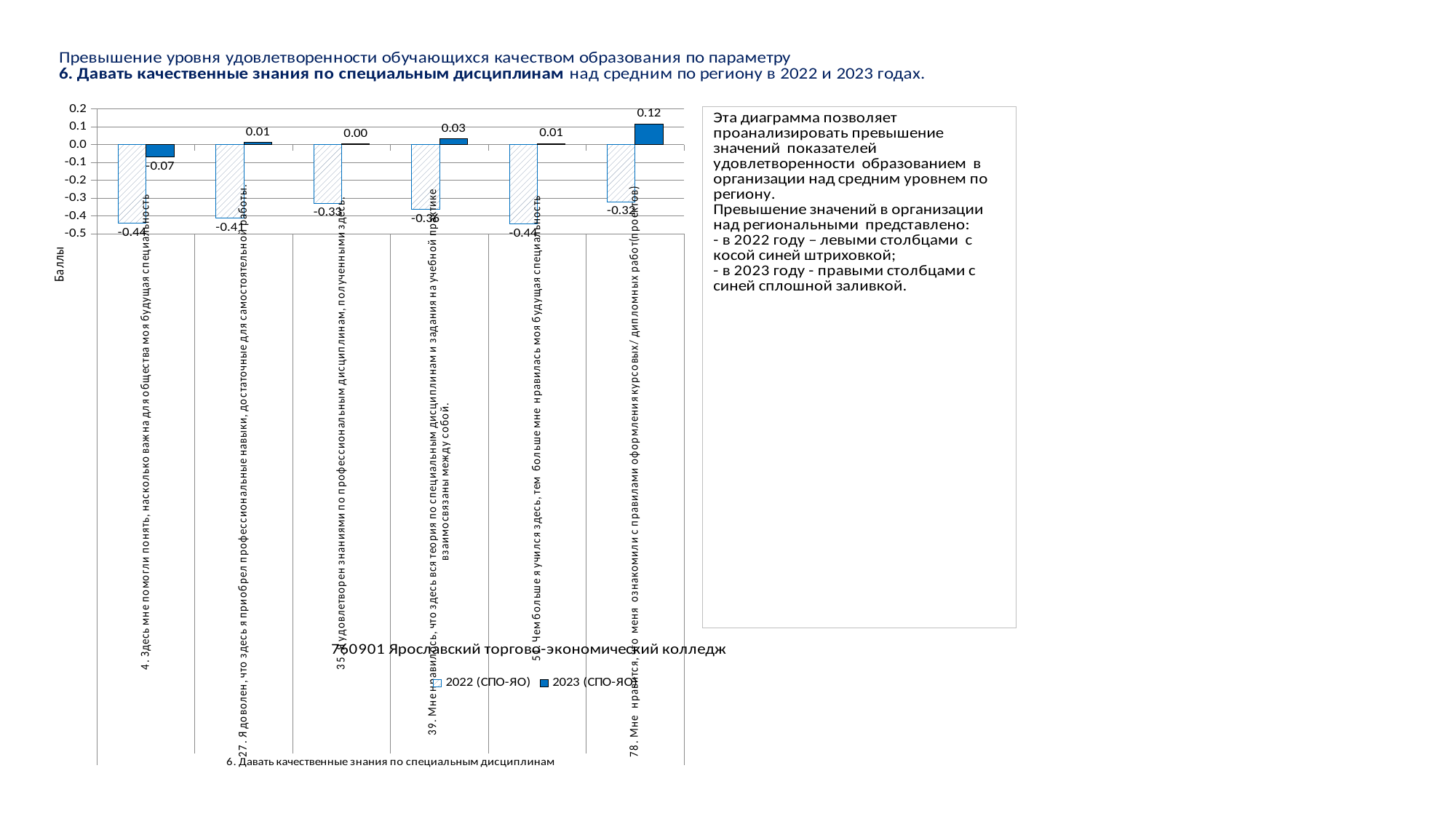
What is the 2023 (СПО-ЯО) value for category 35 (Я удовлетворен знаниями по профессиональным дисциплинам, полученными здесь)? 0.00 What kind of chart is shown on the slide? Bar chart Which category has the highest 2023 (СПО-ЯО) value? 78. Мне нравится, что меня ознакомили с правилами оформления курсовых/дипломных работ Is the 2022 (СПО-ЯО) value for category 27 greater or less than -0.3? less Which is larger, the 2022 (СПО-ЯО) value for category 35 or for category 39? Category 35 What is the difference between the 2023 and 2022 values for category 78? 0.44 What is the 2022 (СПО-ЯО) value for category 4 (Здесь мне помогли понять, насколько важна для общества моя будущая специальность)? -0.44 What are the two series named in the legend? 2022 (СПО-ЯО) and 2023 (СПО-ЯО) What is the 2023 (СПО-ЯО) value for category 78 (Мне нравится, что меня ознакомили с правилами оформления курсовых/дипломных работ)? 0.12 Which category has the lowest 2023 (СПО-ЯО) value? 4. Здесь мне помогли понять, насколько важна для общества моя будущая специальность How many series does the legend list? 2 How many categories are shown on the chart? 6